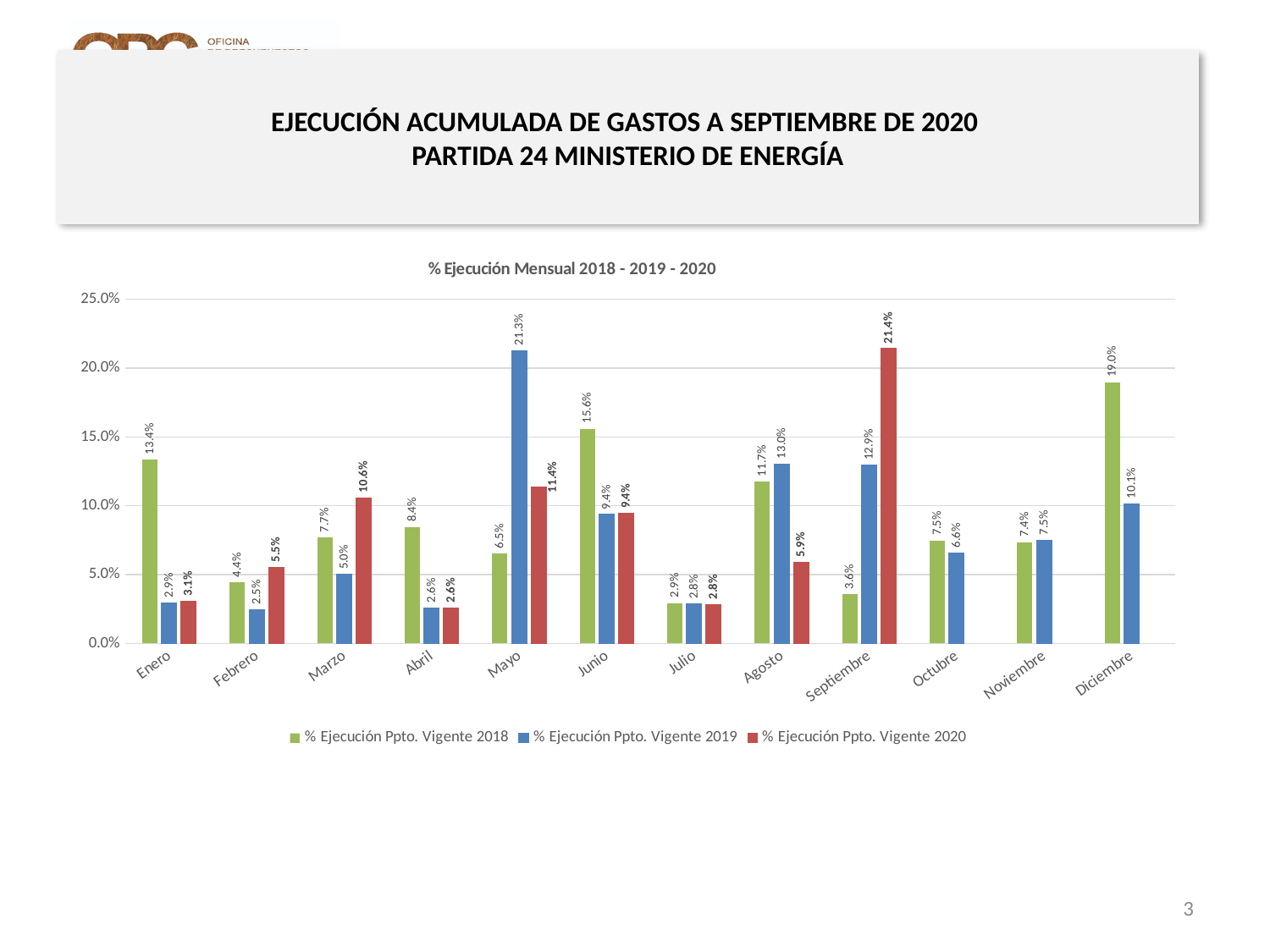
What is the value for % Ejecución Ppto. Vigente 2019 in Mayo? 21.3% In which month is the % Ejecución Ppto. Vigente 2018 series lowest? Julio What is the difference between the 2020 and 2018 values in Marzo? 2.9% How many months are shown on the x axis? 12 Which is larger in Agosto: the 2019 value or the 2020 value? 2019 value (13.0%) What is the value for % Ejecución Ppto. Vigente 2020 in Septiembre? 21.4% Is the value for % Ejecución Ppto. Vigente 2018 in Enero greater or less than 10.0%? greater In which month is the % Ejecución Ppto. Vigente 2020 series highest? Septiembre What kind of chart is shown on the slide? Bar chart What is the value for % Ejecución Ppto. Vigente 2018 in Diciembre? 19.0% How many series does the legend list? 3 What is the title of the chart? % Ejecución Mensual 2018 - 2019 - 2020